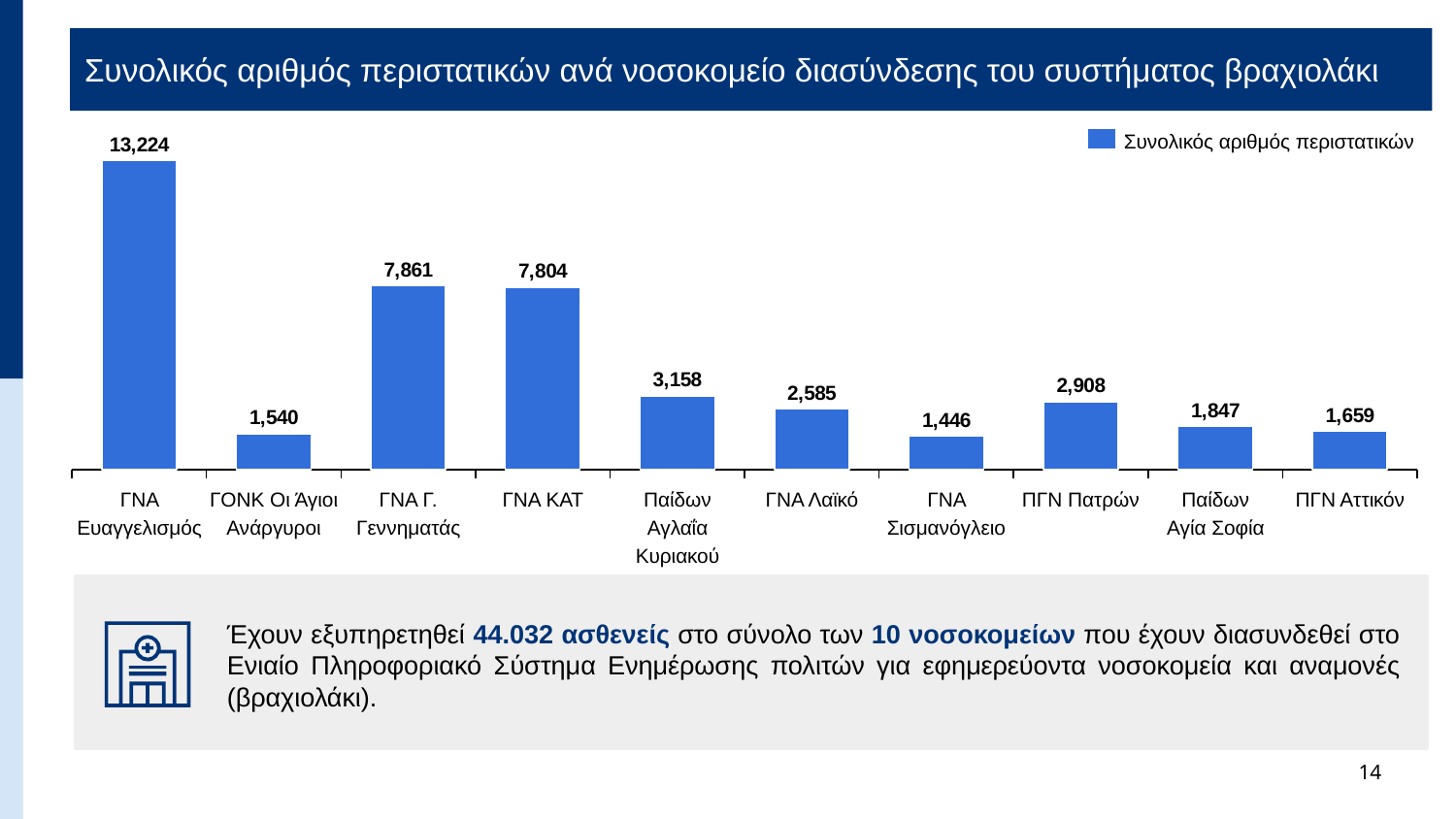
What is the value shown for ΠΓΝ Αττικόν? 1,659 What is the difference between the values for ΓΝΑ Γ. Γεννηματάς and ΓΝΑ ΚΑΤ? 57 What is the value shown for ΓΝΑ ΚΑΤ? 7,804 How many hospitals are shown on the chart? 10 Which hospital has the lowest number of cases? ΓΝΑ Σισμανόγλειο What is the difference between the values for ΓΝΑ Ευαγγελισμός and ΓΝΑ Γ. Γεννηματάς? 5,363 How many series does the legend list? 1 Which has a larger value, ΠΓΝ Πατρών or ΓΝΑ Λαϊκό? ΠΓΝ Πατρών What is the value shown for Παίδων Αγλαΐα Κυριακού? 3,158 Which hospital has the highest number of cases? ΓΝΑ Ευαγγελισμός What is the total number of cases for ΓΝΑ Ευαγγελισμός? 13,224 What kind of chart is shown on the slide? Bar chart